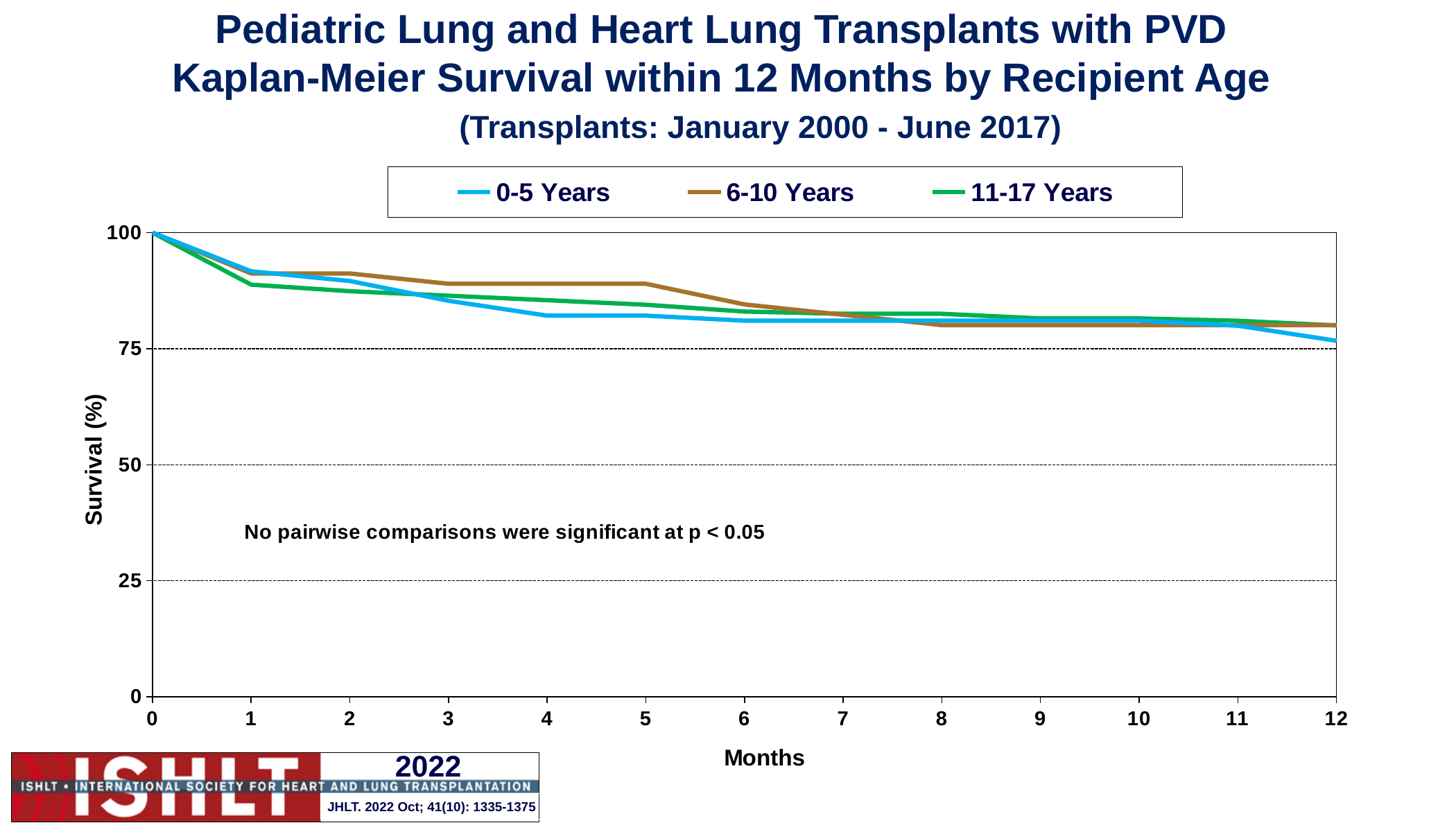
Is the survival value for 6-10 Years at month 5 greater or less than 100? less What is the label of the y axis? Survival (%) At month 12, which is higher: the survival for 6-10 Years or for 0-5 Years? 6-10 Years What kind of chart is shown on the slide? Line chart What note is printed inside the plot area about pairwise comparisons? No pairwise comparisons were significant at p < 0.05 Do the survival curves rise or fall as months increase along the x axis? Fall Is the survival value for 0-5 Years at month 12 greater or less than 75? greater Which age group has the lowest survival at month 12? 0-5 Years How many series does the legend list? 3 At month 4, which is higher: the survival for 6-10 Years or for 0-5 Years? 6-10 Years Which age group has the highest survival at month 5? 6-10 Years What is the survival value for all three age groups at month 0? 100